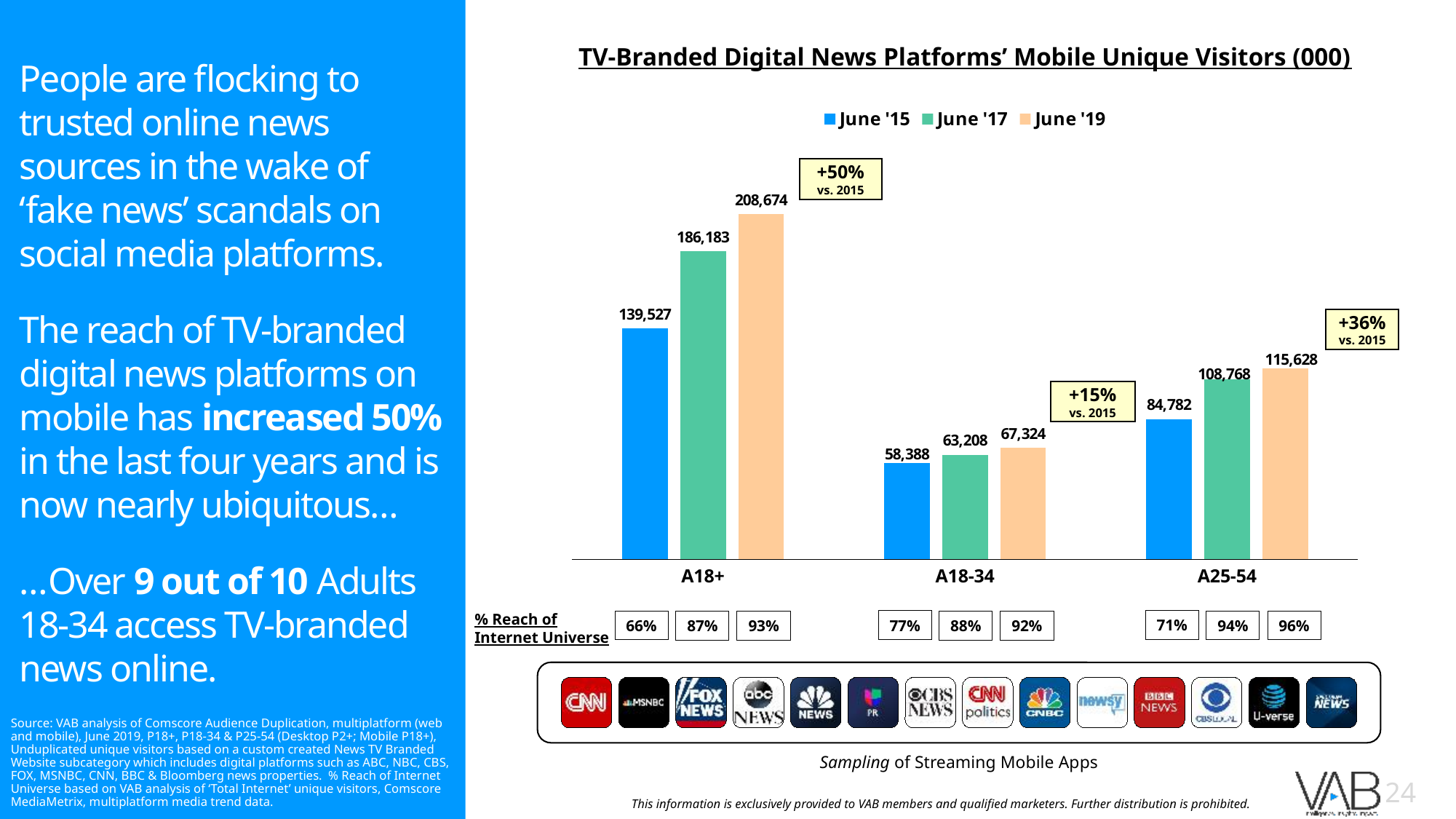
Which age group has the highest June '19 value? A18+ What is the difference between the June '19 and June '15 values for A18+? 69,147 What is the June '17 value for A25-54? 108,768 What is the June '19 value for A18+? 208,674 Which is larger: the June '17 value for A18-34 or the June '15 value for A25-54? June '15 value for A25-54 How many series does the legend list? 3 How many age groups are shown on the x axis? 3 What is the June '15 value for A18-34? 58,388 What kind of chart is shown? Bar chart Which age group has the lowest June '15 value? A18-34 For A25-54, do the values rise or fall from June '15 to June '19? Rise What is the title of the chart? TV-Branded Digital News Platforms' Mobile Unique Visitors (000)